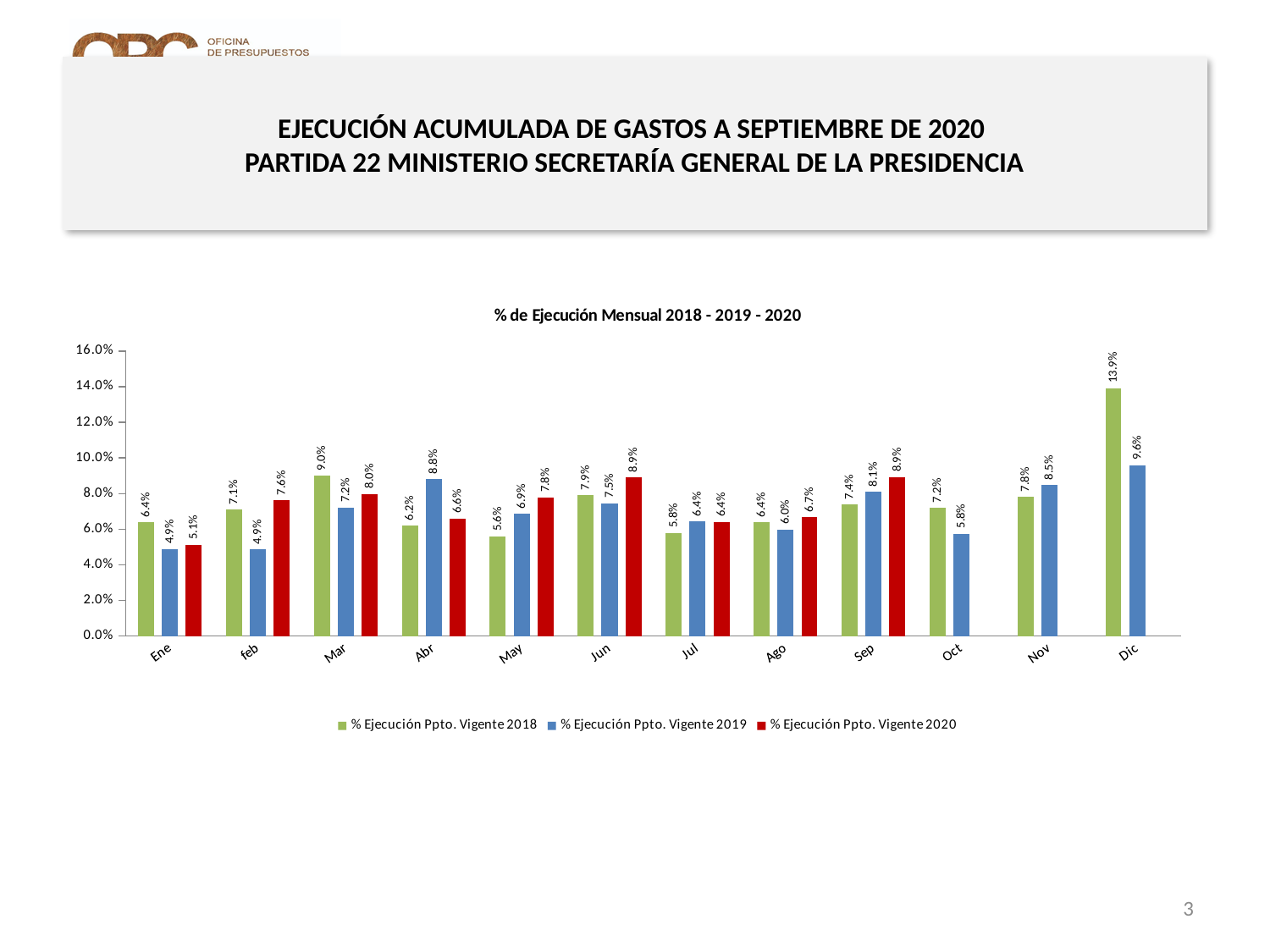
What is the difference between the 2020 and 2019 values in Sep? 0.8% What is the title of the chart? % de Ejecución Mensual 2018 - 2019 - 2020 How many months are shown on the x axis? 12 What is the value for % Ejecución Ppto. Vigente 2019 in Abr? 8.8% What is the value for % Ejecución Ppto. Vigente 2018 in Dic? 13.9% In which month is the % Ejecución Ppto. Vigente 2018 series highest? Dic What is the value for % Ejecución Ppto. Vigente 2020 in Mar? 8.0% In which month is the % Ejecución Ppto. Vigente 2018 series lowest? May How many series does the legend list? 3 What kind of chart is shown on the slide? Bar chart Is the value for % Ejecución Ppto. Vigente 2019 in Dic greater or less than 8.0%? greater Which is larger in Abr: the 2019 value or the 2018 value? 2019